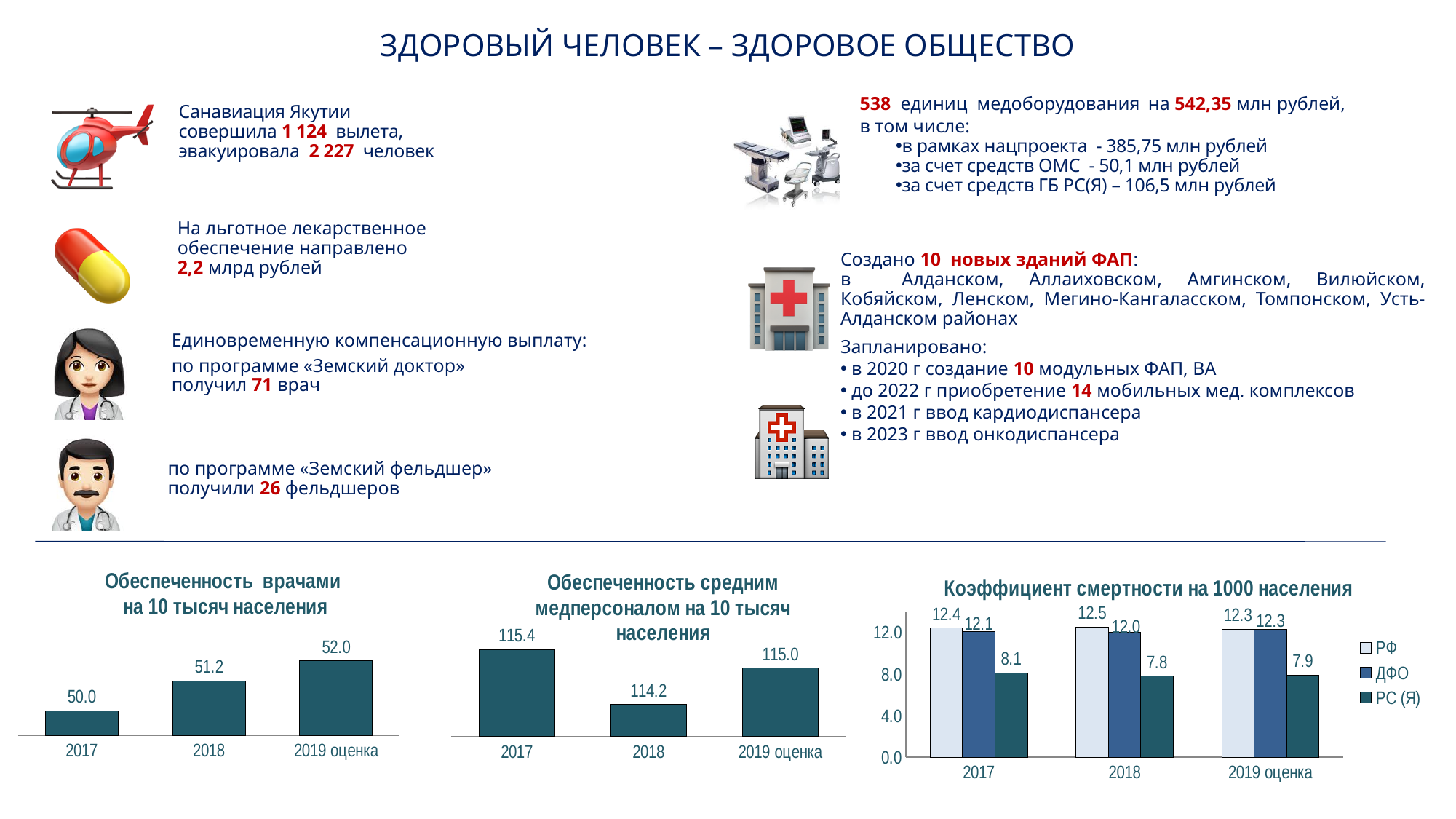
In the chart 'Обеспеченность средним медперсоналом на 10 тысяч населения', what is the value for 2017? 115.4 In the chart 'Обеспеченность средним медперсоналом на 10 тысяч населения', how many years are shown on the x axis? 3 In the chart 'Обеспеченность средним медперсоналом на 10 тысяч населения', which year has the lowest value? 2018 In the chart 'Обеспеченность врачами на 10 тысяч населения', do the values rise or fall from 2017 to 2019 оценка? rise In the chart 'Коэффициент смертности на 1000 населения', which is larger in 2017: the value for РФ or the value for РС (Я)? РФ In the chart 'Обеспеченность врачами на 10 тысяч населения', what is the value for 2018? 51.2 What type of chart is 'Коэффициент смертности на 1000 населения'? bar chart In the chart 'Обеспеченность врачами на 10 тысяч населения', what is the difference between the 2019 оценка value and the 2017 value? 2.0 In the chart 'Коэффициент смертности на 1000 населения', what is the difference between the РФ value and the РС (Я) value in 2019 оценка? 4.4 In the chart 'Обеспеченность врачами на 10 тысяч населения', which year has the highest value? 2019 оценка In the chart 'Коэффициент смертности на 1000 населения', how many series does the legend list? 3 In the chart 'Коэффициент смертности на 1000 населения', what is the value for РС (Я) in 2018? 7.8